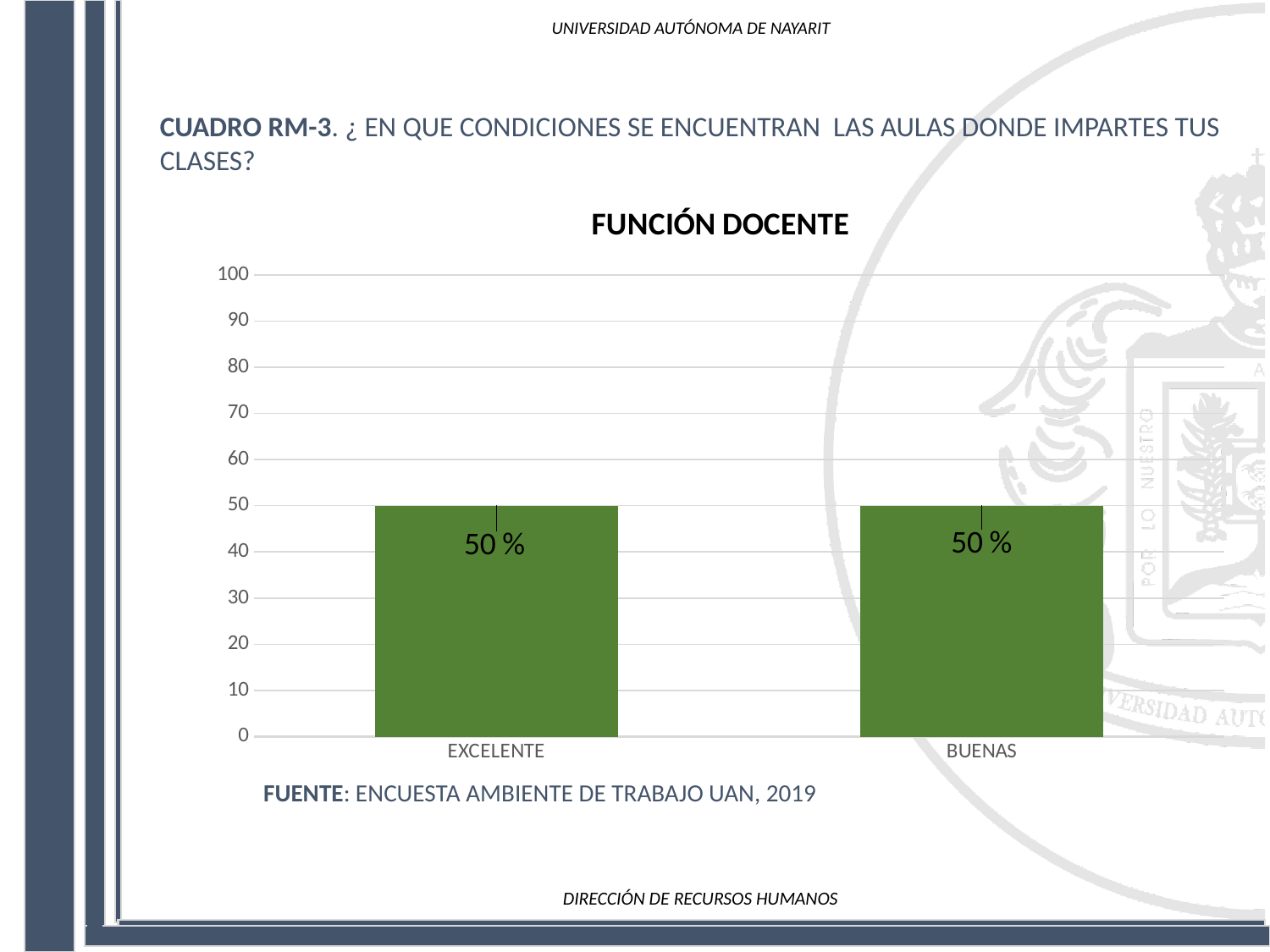
Is the value for BUENAS greater or less than 20? greater What is the difference between the values for EXCELENTE and BUENAS? 0 What is the title of the chart? FUNCIÓN DOCENTE What is the highest value shown on the y axis? 100 What is the value for EXCELENTE? 50 % How many categories are shown on the x axis? 2 Is the value for EXCELENTE greater or less than 80? less What is the total of the values for EXCELENTE and BUENAS? 100 % What kind of chart is shown on the slide? bar chart What is the value for BUENAS? 50 %